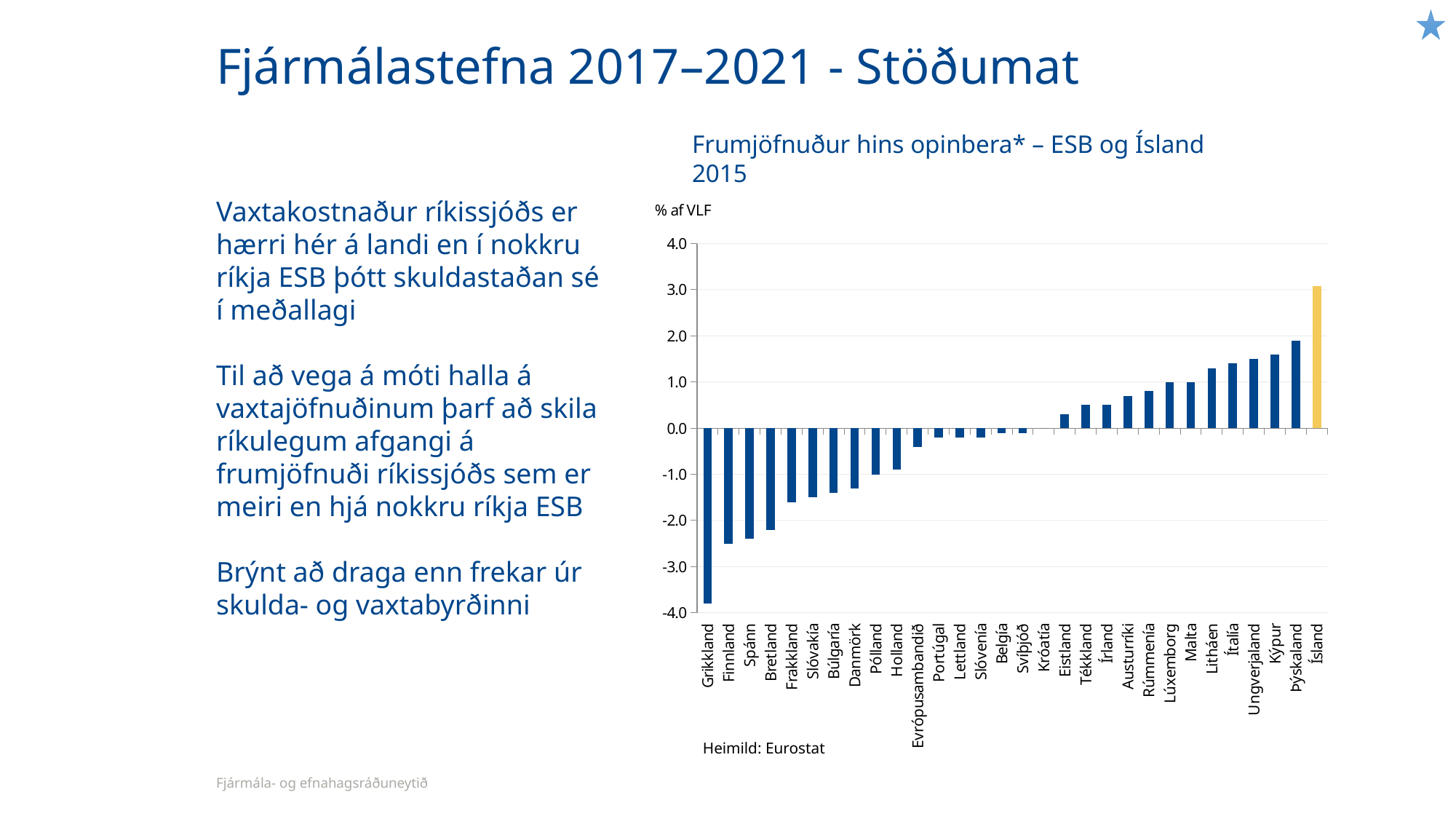
How many categories are plotted along the x axis? 30 Is the value for Ísland greater or less than 2.0? greater Which is larger, the value for Ísland or the value for Þýskaland? Ísland Is the value for Finnland greater or less than -2.0? less Which country has the lowest primary balance in the chart? Grikkland Which country has the highest primary balance in the chart? Ísland What unit is shown on the vertical axis label of the chart? % af VLF What kind of chart is shown on the slide? bar chart Is the value for Grikkland greater or less than -3.0? less Do the values rise or fall moving from left to right along the x axis? rise